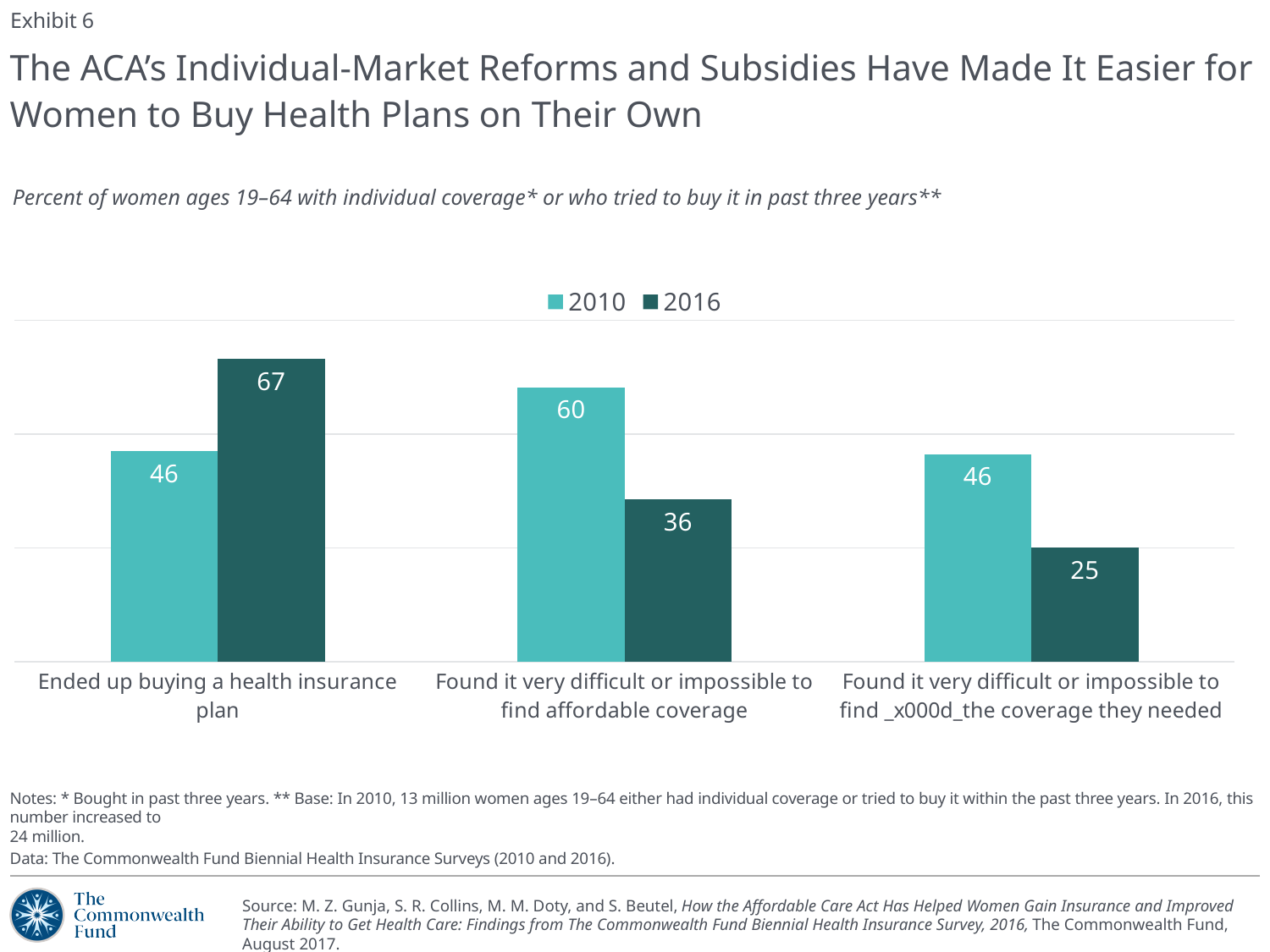
What kind of chart is shown on the slide? Bar chart For "Found it very difficult or impossible to find the coverage they needed", which year has the larger value, 2010 or 2016? 2010 How many categories are shown on the x axis? 3 How many series does the legend list? 2 What is the 2016 value for "Found it very difficult or impossible to find the coverage they needed"? 25 What is the 2016 value for "Ended up buying a health insurance plan"? 67 Which two years are listed in the legend? 2010 and 2016 Which category has the lowest 2016 value? Found it very difficult or impossible to find the coverage they needed What is the difference between the 2016 and 2010 values for "Ended up buying a health insurance plan"? 21 What is the difference between the 2010 and 2016 values for "Found it very difficult or impossible to find affordable coverage"? 24 Which category has the highest 2016 value? Ended up buying a health insurance plan What is the 2010 value for "Found it very difficult or impossible to find affordable coverage"? 60